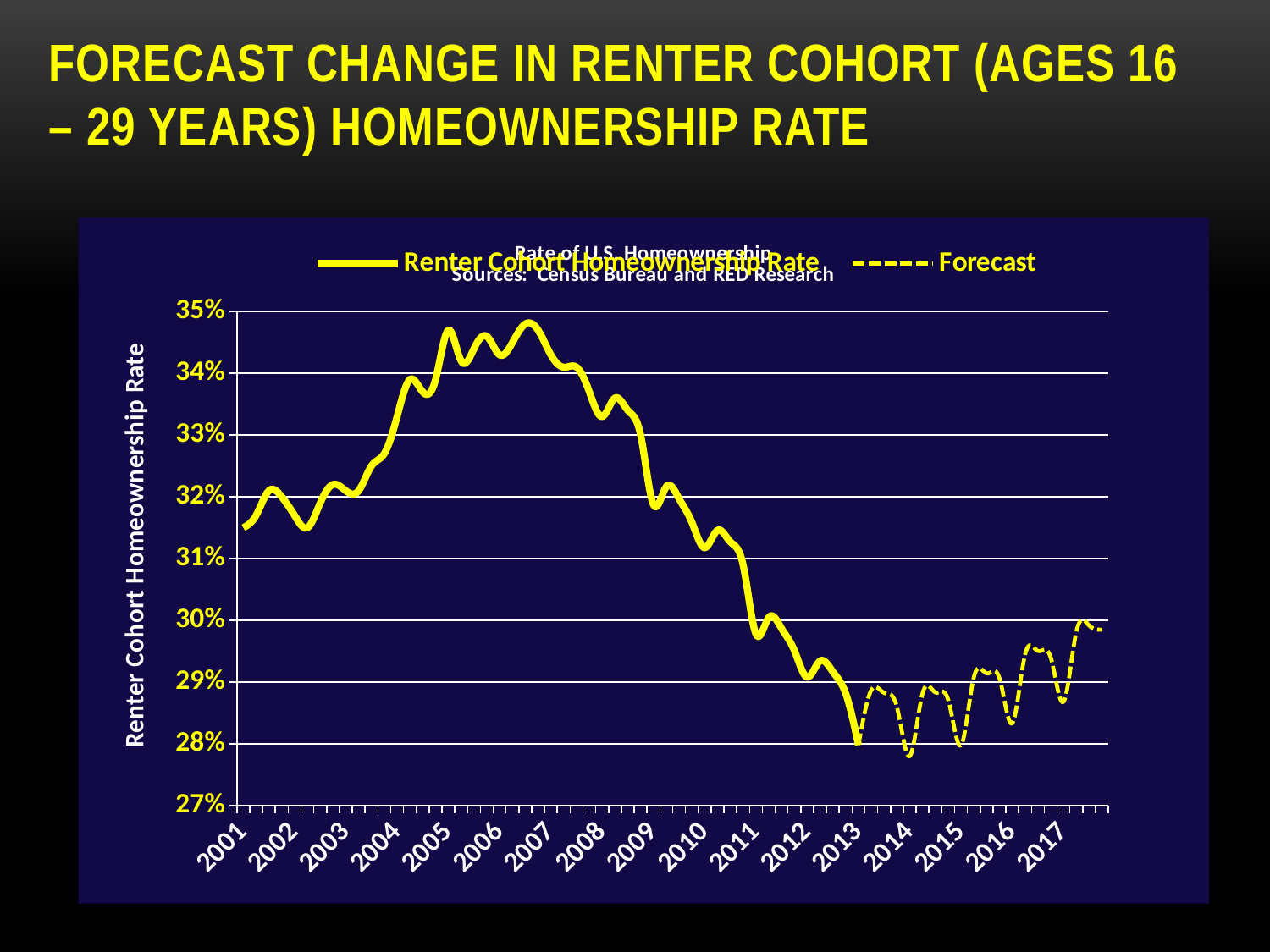
Is the forecast renter cohort homeownership rate at the start of 2015 greater or less than 29%? less How many series does the chart legend list? 2 Does the renter cohort homeownership rate rise or fall between 2007 and 2013? fall Is the renter cohort homeownership rate at the start of 2001 greater or less than 31%? greater Does the forecast line rise or fall overall between 2014 and 2017? rise What kind of chart is shown on the slide? line chart Which is larger, the renter cohort homeownership rate in 2005 or in 2012? 2005 What is the label on the vertical axis of the chart? Renter Cohort Homeownership Rate What are the two series named in the chart legend? Renter Cohort Homeownership Rate and Forecast Is the renter cohort homeownership rate at the start of 2012 greater or less than 30%? less How many years are labelled along the x axis of the chart? 17